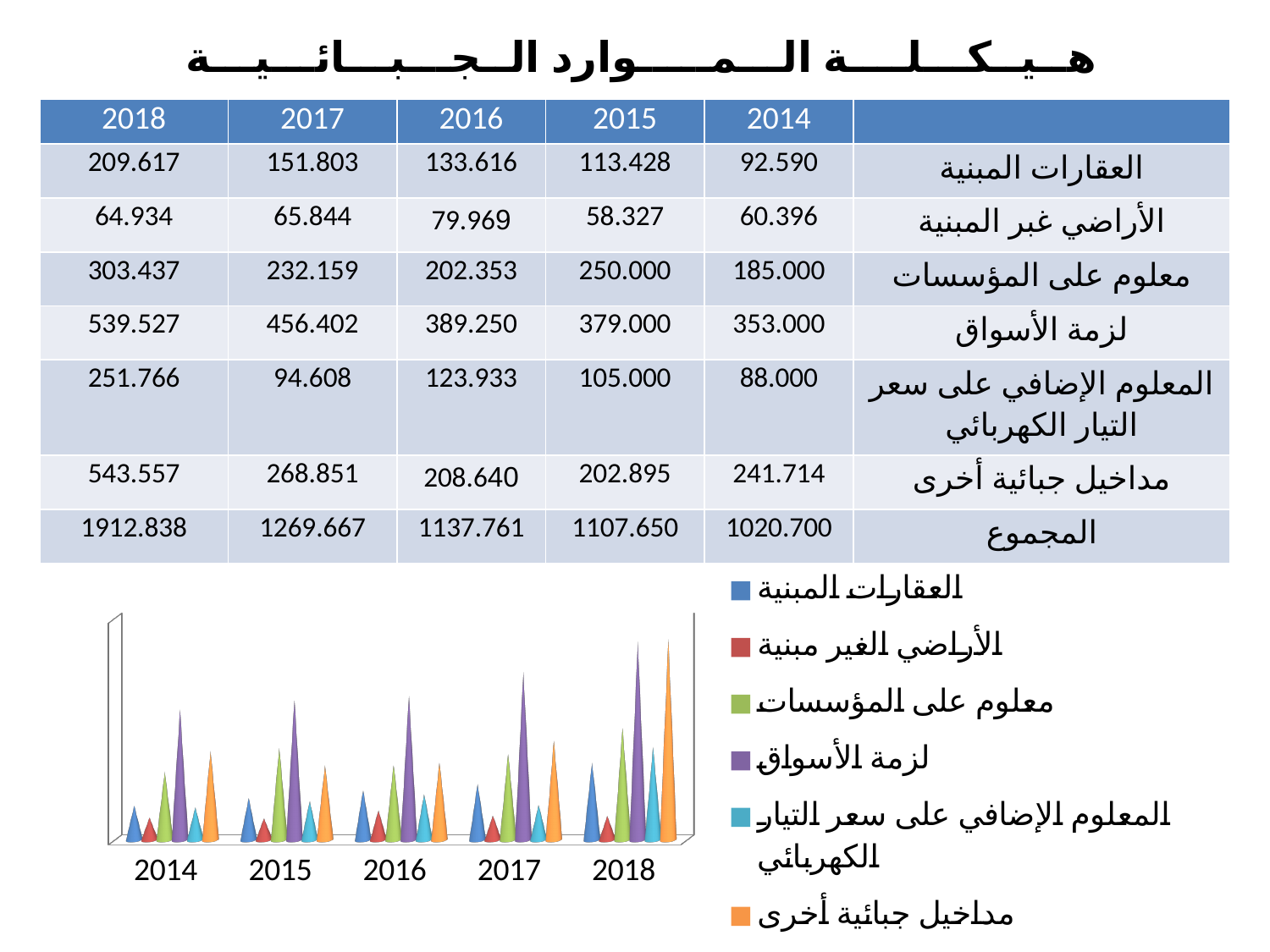
According to the table, what is the value of لزمة الأسواق in 2018? 539.527 How many years (categories) are shown along the x axis of the chart? 5 Do the bars for لزمة الأسواق rise or fall from 2014 to 2018? rise For 2018, which is larger: the bar for العقارات المبنية or the bar for الأراضي غير المبنية? العقارات المبنية What is the difference between the total (المجموع) for 2018 and the total for 2017? 643.171 Which series has the tallest bar for 2017? لزمة الأسواق What kind of chart is shown at the bottom of the slide? bar chart According to the table, what is the total (المجموع) for 2017? 1269.667 How many series does the chart legend list? 6 According to the table, what is the value of العقارات المبنية in 2014? 92.590 Which colour represents مداخيل جبائية أخرى in the chart legend? orange Which series has the shortest bar for 2018? الأراضي غير المبنية